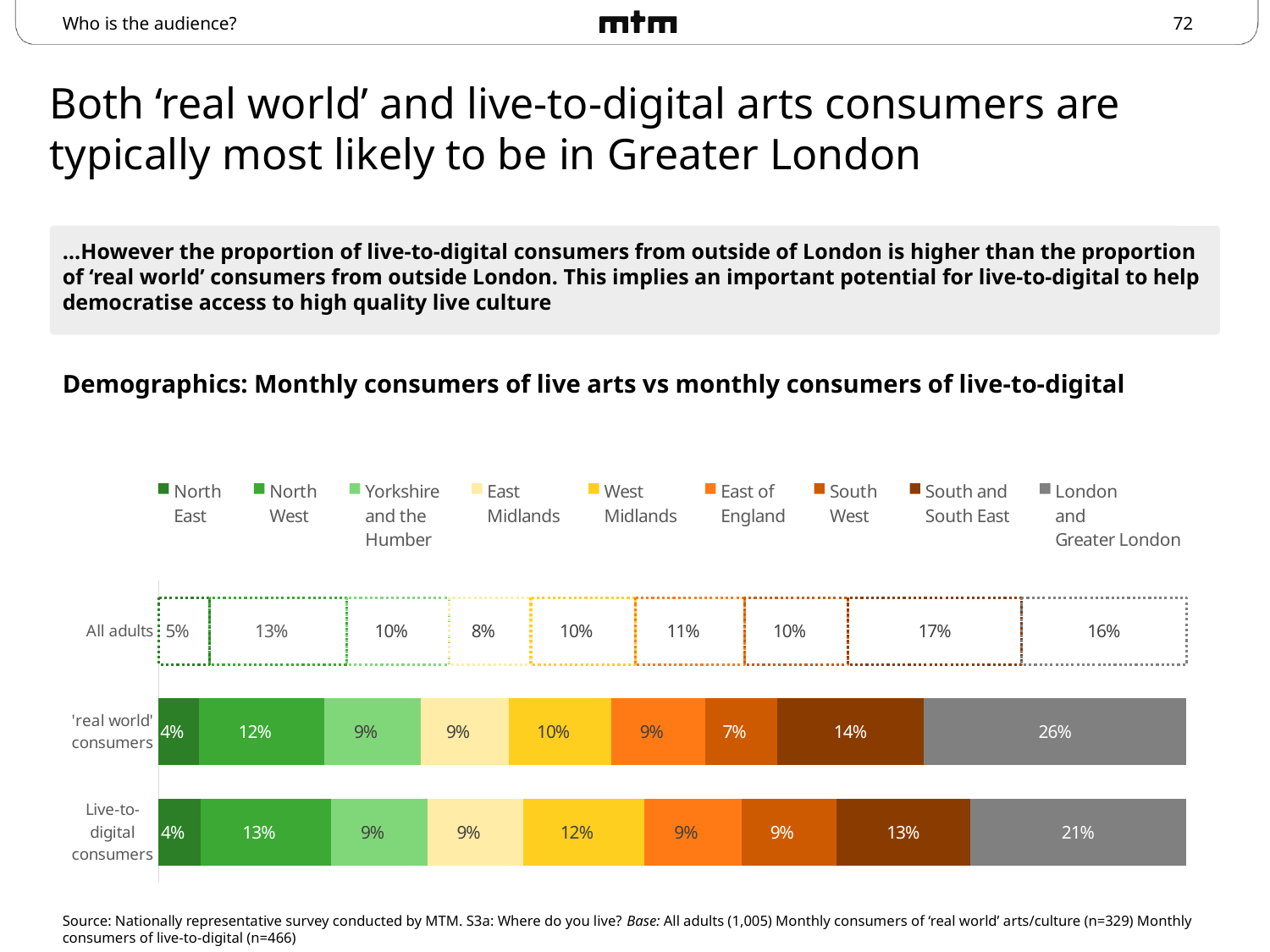
What percentage of live-to-digital consumers are in the West Midlands? 12% Which region has the smallest share of live-to-digital consumers? North East Which is larger: the South West share for 'real world' consumers or for live-to-digital consumers? Live-to-digital consumers How many series does the legend list? 9 How many bars (categories) are plotted in the chart? 3 Which region has the largest share of 'real world' consumers? London and Greater London What percentage of 'real world' consumers are in London and Greater London? 26% What percentage of live-to-digital consumers are in London and Greater London? 21% What is the title of the chart? Demographics: Monthly consumers of live arts vs monthly consumers of live-to-digital What is the difference between the London and Greater London share for 'real world' consumers and for live-to-digital consumers? 5% What kind of chart is shown on the slide? Stacked bar chart What percentage of all adults are in the South and South East? 17%